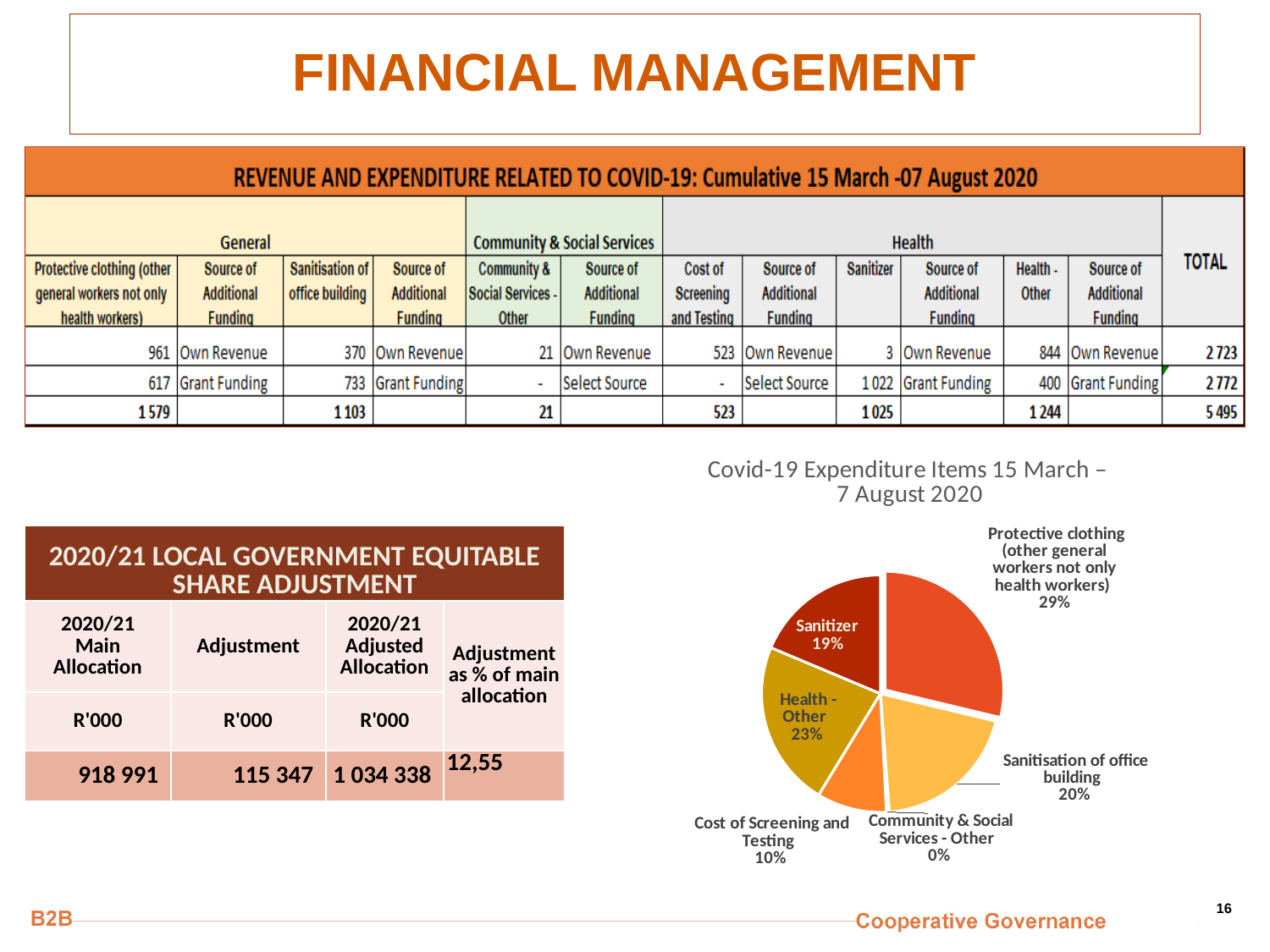
In the pie chart, which is larger: Health - Other or Sanitizer? Health - Other In the pie chart, what is the difference in percentage points between Protective clothing and Cost of Screening and Testing? 19 In the pie chart, what share is shown for Health - Other? 23% In the pie chart, what share is shown for Sanitisation of office building? 20% What kind of chart is shown under the title "Covid-19 Expenditure Items 15 March – 7 August 2020"? Pie chart In the pie chart, what share is shown for Community & Social Services - Other? 0% Which slice of the pie chart has the smallest share? Community & Social Services - Other In the pie chart, what share is shown for Cost of Screening and Testing? 10% Which slice of the pie chart has the largest share? Protective clothing (other general workers not only health workers) In the pie chart, what share is shown for Protective clothing (other general workers not only health workers)? 29% In the pie chart, what share is shown for Sanitizer? 19% How many slices are labelled in the pie chart? 6